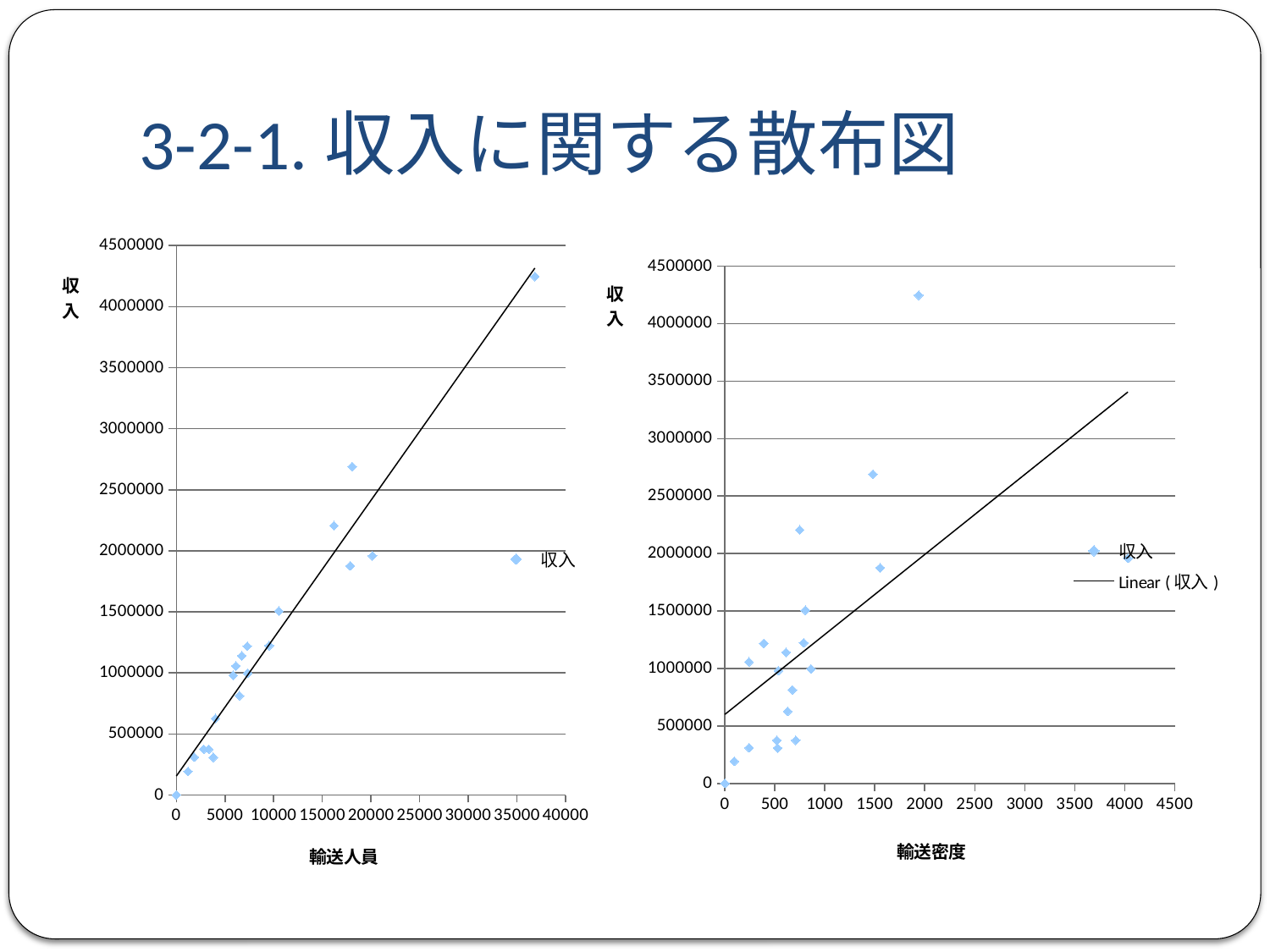
In the right chart, how many points have a 収入 value above 2500000? 2 In the left chart, do the 収入 values generally rise or fall as 輸送人員 increases? rise What is the x-axis label of the right chart? 輸送密度 In the left chart, how many points have a 収入 value above 4000000? 1 In the right chart, does the trend line rise or fall as 輸送密度 increases? rise In the left chart, how many points have a 収入 value above 2500000? 2 What is the maximum value shown on the y-axis of the left chart? 4500000 In the right chart, is the highest 収入 value plotted greater or less than 4000000? greater How many entries does the legend of the right chart list? 2 What is the x-axis label of the left chart? 輸送人員 What kind of chart is the left chart on the slide? scatter chart In the left chart, is the 収入 value of the point with the largest 輸送人員 greater or less than 4000000? greater